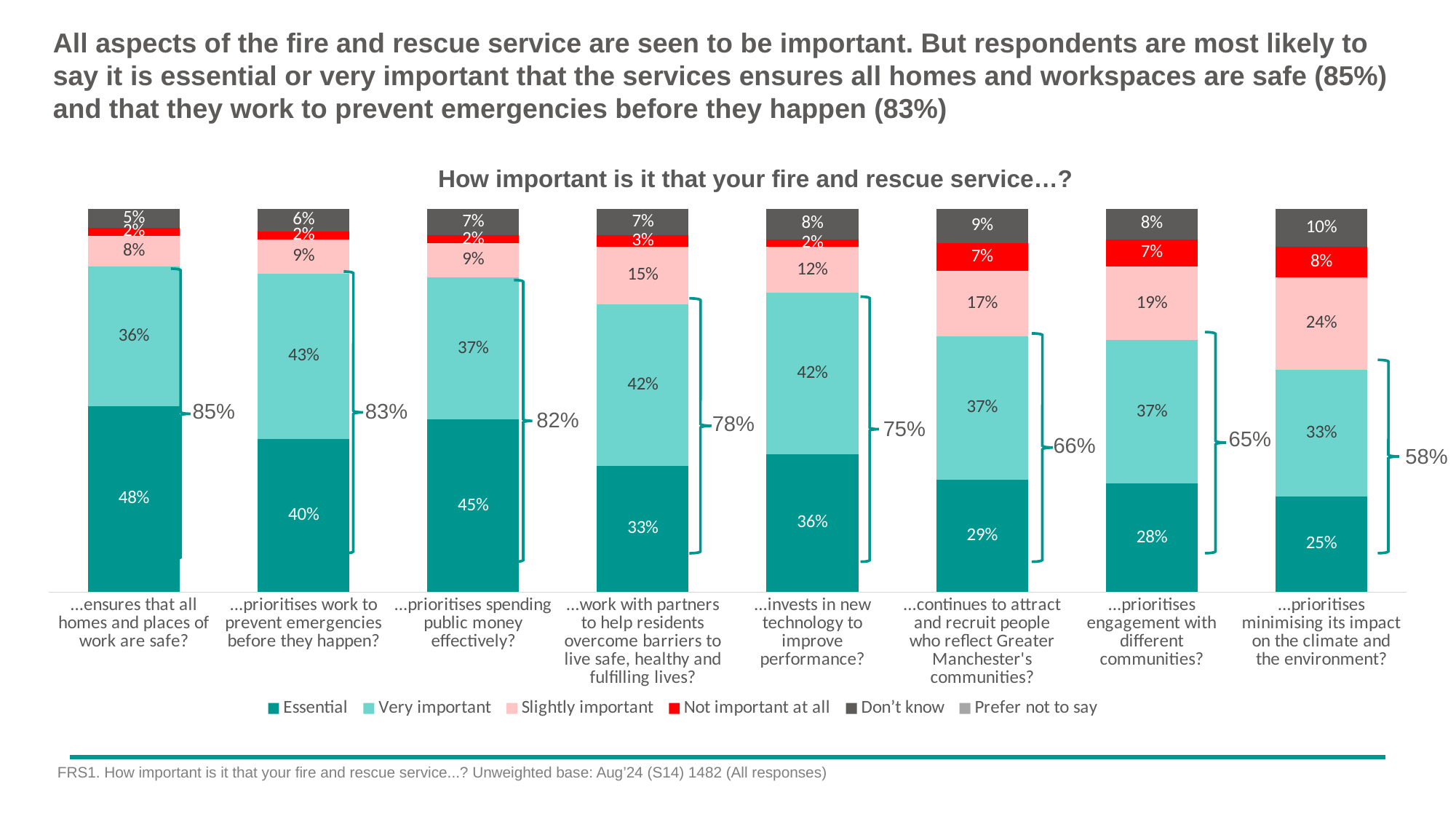
What percentage of respondents said it is essential that the fire and rescue service ensures that all homes and places of work are safe? 48% What is the title of the chart? How important is it that your fire and rescue service…? How many series does the legend list? 6 Which category has the lowest 'Essential' percentage? ...prioritises minimising its impact on the climate and the environment? Which has a larger 'Not important at all' percentage: 'continues to attract and recruit people who reflect Greater Manchester's communities' or 'invests in new technology to improve performance'? ...continues to attract and recruit people who reflect Greater Manchester's communities? What is the difference between the 'Essential' percentages for 'prioritises spending public money effectively' and 'work with partners to help residents overcome barriers to live safe, healthy and fulfilling lives'? 12% What percentage of respondents said it is slightly important that the service prioritises minimising its impact on the climate and the environment? 24% What percentage of respondents said it is very important that the service prioritises work to prevent emergencies before they happen? 43% How many categories (questions) are shown on the x axis of the chart? 8 What is the combined essential or very important percentage shown for 'invests in new technology to improve performance'? 75% What type of chart is shown on the slide? Stacked bar chart Which category has the highest 'Essential' percentage? ...ensures that all homes and places of work are safe?